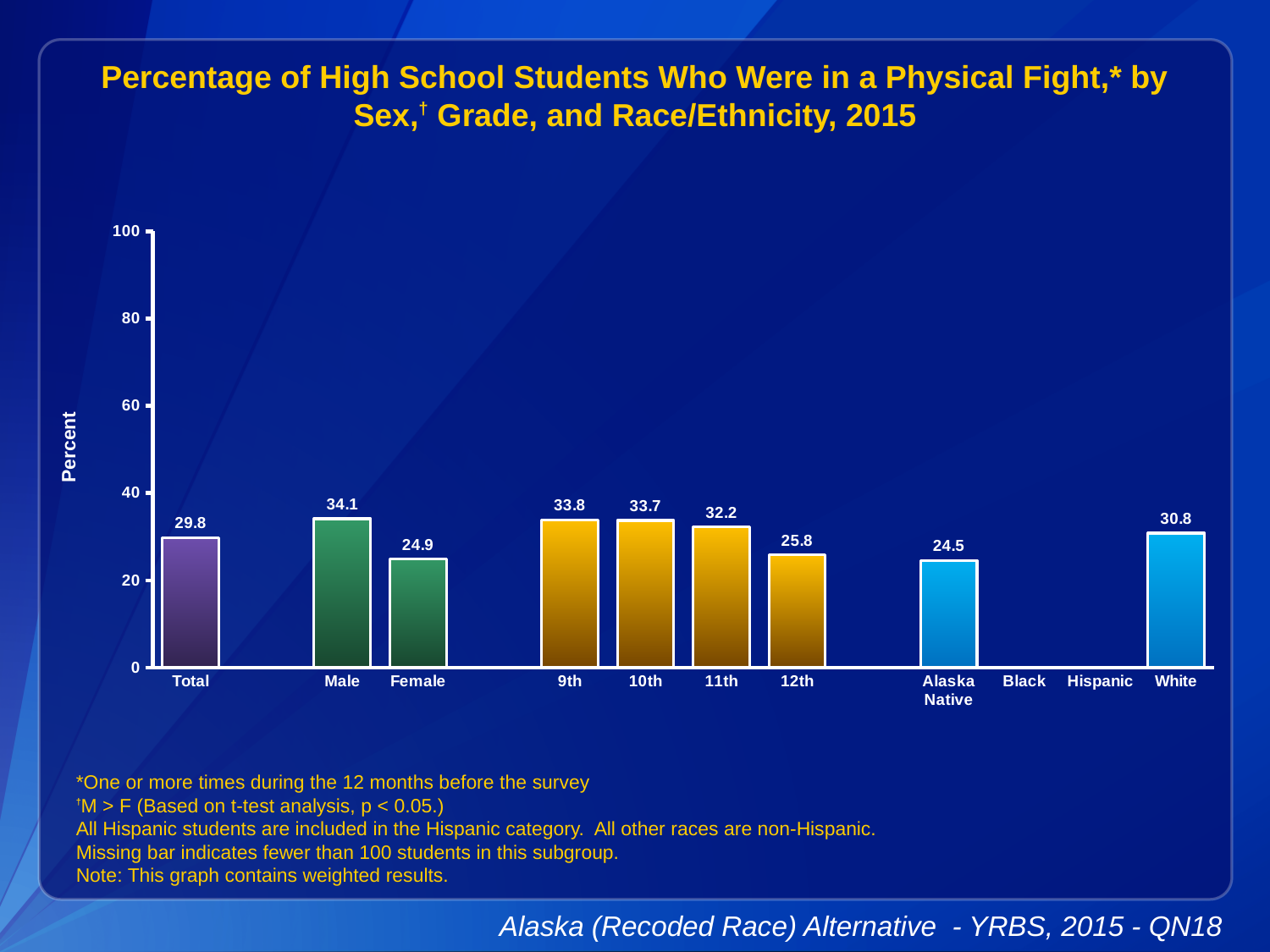
What is the value for Total? 29.8 Which category has the highest value? Male What is the difference between the Male and Female values? 9.2 What kind of chart is shown on the slide? bar chart Which is larger, the value for 9th grade or the value for 12th grade? 9th Which category with a bar has the lowest value? Alaska Native What is the value for 12th grade? 25.8 Do the values fall or rise from 9th grade to 12th grade? fall Is the value for 11th grade greater or less than 40? less How many categories on the x axis have no bar shown? 2 What is the value for Male? 34.1 What is the value for White? 30.8